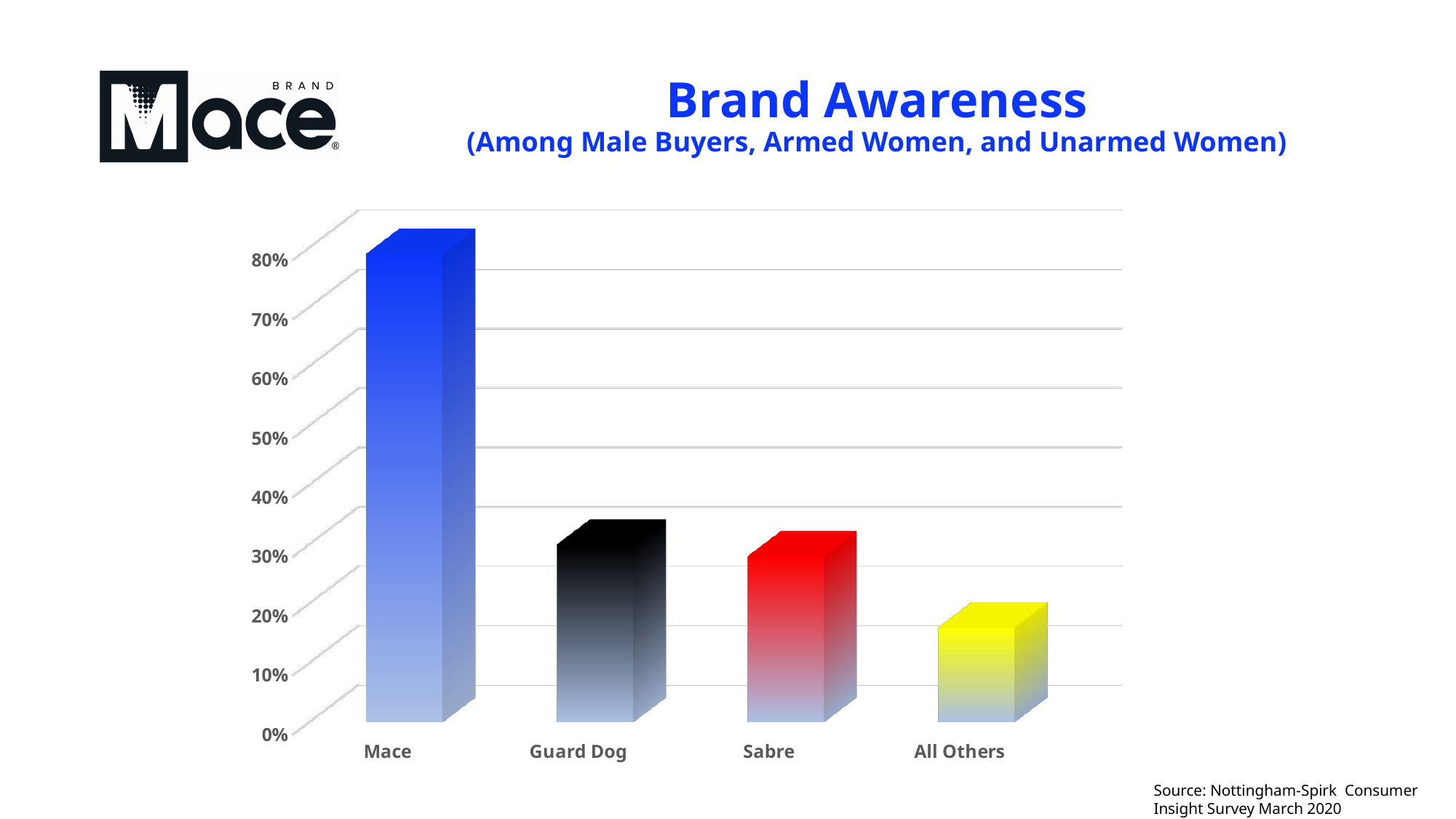
Is the value for Sabre greater or less than 40%? less What is the title of the chart? Brand Awareness Which brand has the highest awareness? Mace Is the value for Mace greater or less than 70%? greater What kind of chart is shown on the slide? Bar chart Which is larger, the value for Mace or the value for Guard Dog? Mace Is the value for All Others greater or less than 30%? less Which category has the lowest awareness? All Others How many brand categories are shown on the x axis? 4 Which is larger, the value for Sabre or the value for All Others? Sabre